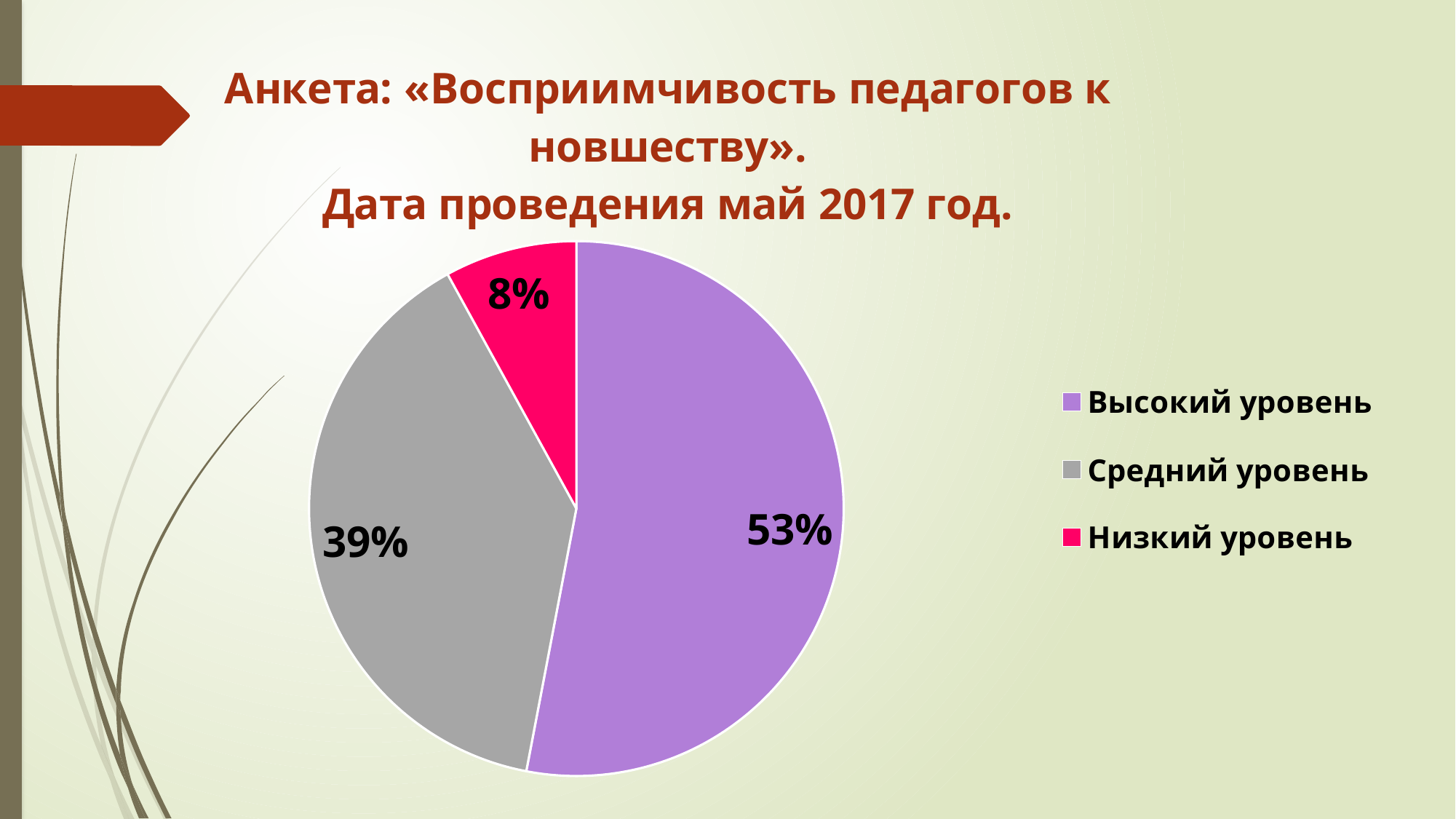
How many entries does the legend list? 3 Which is larger, the slice for Средний уровень or the slice for Низкий уровень? Средний уровень How many slices does the pie chart have? 3 What share of the pie is labelled Высокий уровень? 53% Which category has the largest slice of the pie? Высокий уровень Which category has the smallest slice of the pie? Низкий уровень What is the difference in percentage points between Средний уровень and Низкий уровень? 31 What share of the pie is labelled Низкий уровень? 8% What share of the pie is labelled Средний уровень? 39% What colour is the slice for Низкий уровень? pink What kind of chart is shown on the slide? pie chart What is the difference in percentage points between Высокий уровень and Средний уровень? 14